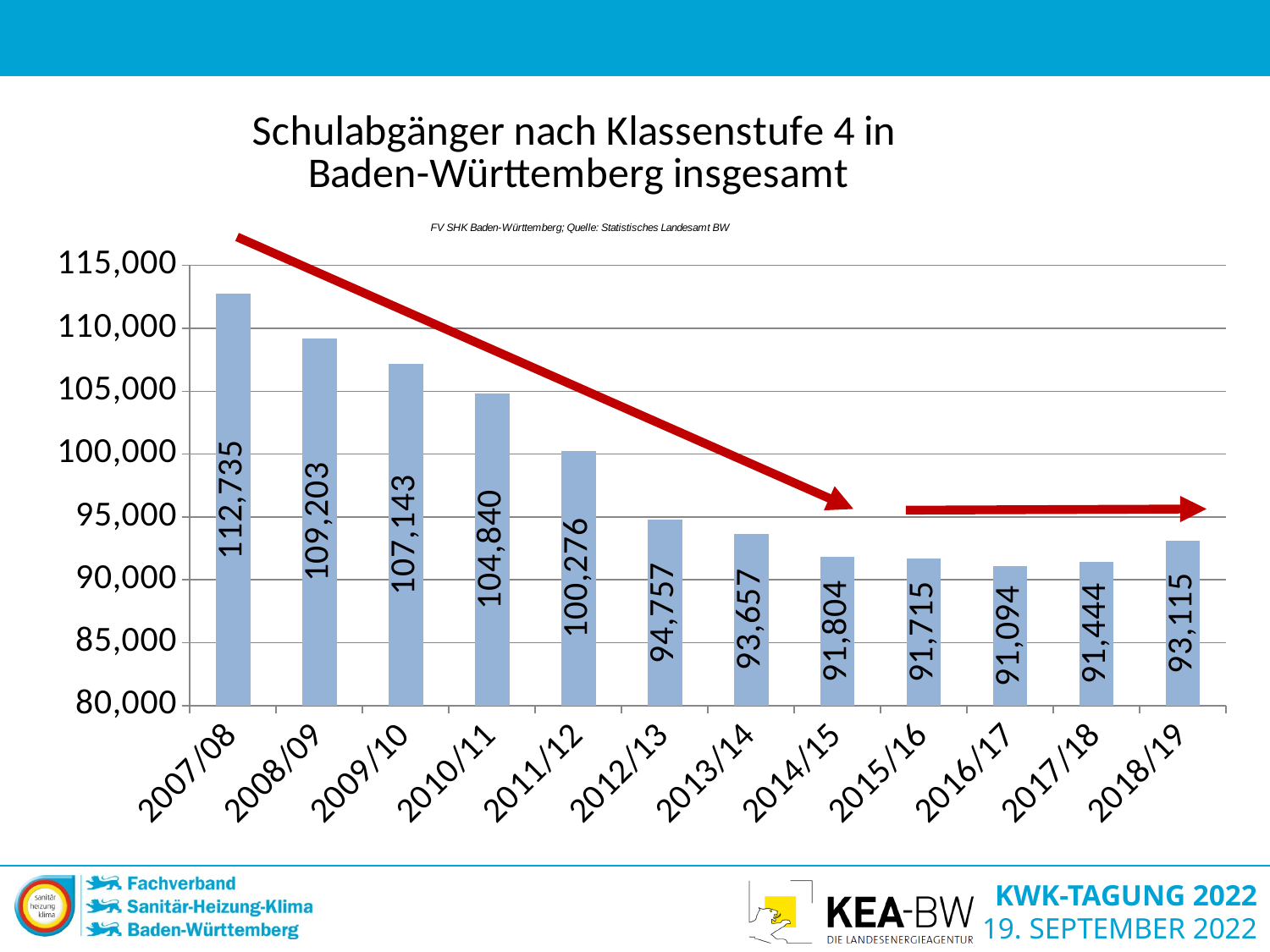
What is the value for 2007/08? 112,735 What is the difference between the values for 2007/08 and 2018/19? 19,620 Is the value for 2010/11 greater or less than 100,000? greater How many school years are shown on the x axis? 12 What is the value for 2018/19? 93,115 What is the difference between the values for 2011/12 and 2012/13? 5,519 What is the value for 2012/13? 94,757 Which is larger, the value for 2015/16 or the value for 2017/18? 2015/16 Do the values generally rise or fall from 2007/08 to 2018/19? fall What kind of chart is shown on the slide? bar chart Which school year has the lowest value? 2016/17 Which school year has the highest value? 2007/08